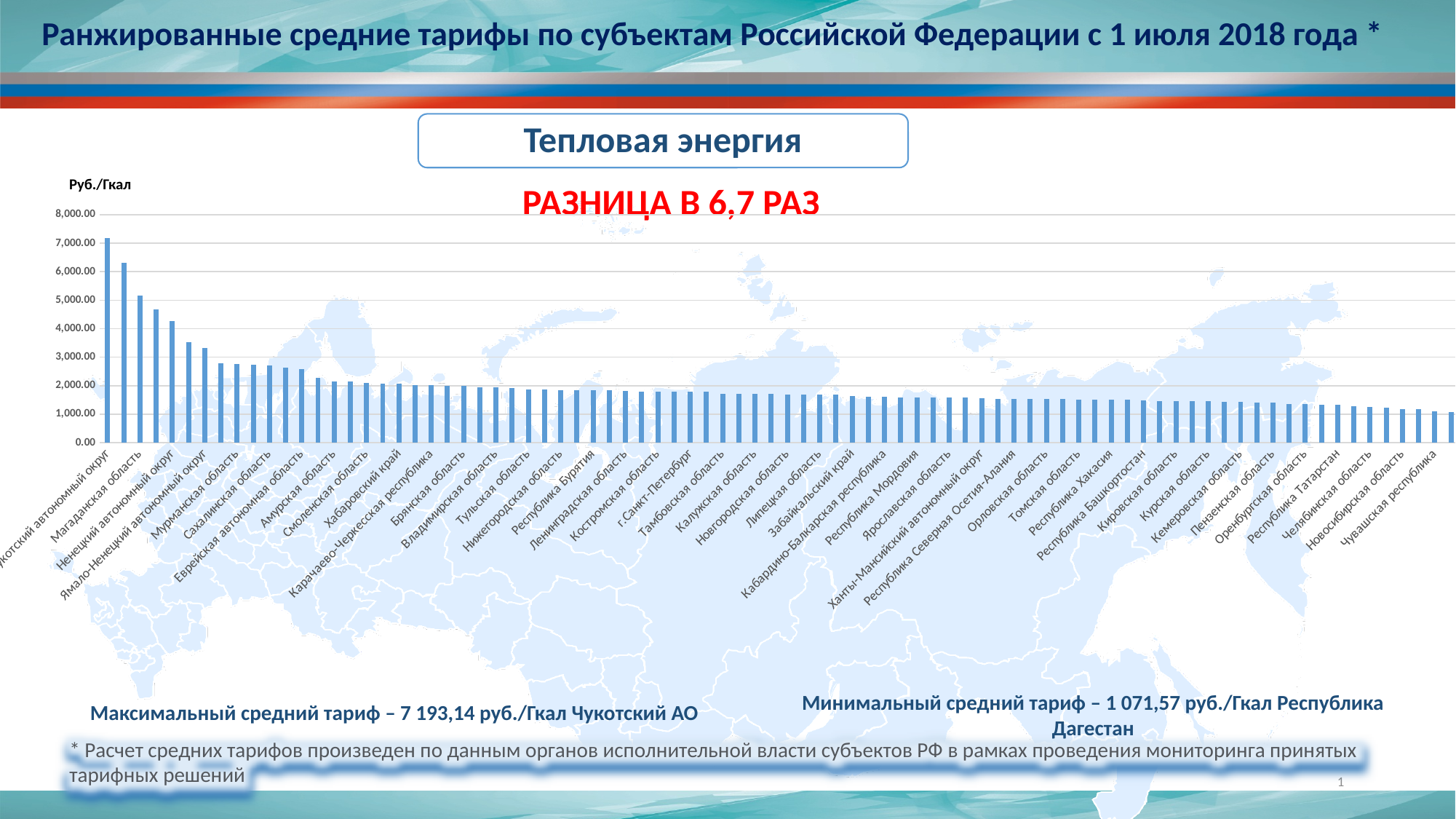
What kind of chart is shown on the slide? bar chart Is the value for Чувашская республика greater or less than 2,000.00? less What unit is shown on the vertical axis of the chart? Руб./Гкал By what factor does the slide say the tariffs differ? 6,7 раз Is the value for Магаданская область greater or less than 4,000.00? greater Is the value for Мурманская область greater or less than 5,000.00? less Which region has the highest average heat energy tariff in the chart? Чукотский автономный округ Which has the larger value, Магаданская область or Мурманская область? Магаданская область What is the maximum average tariff stated on the slide? 7 193,14 руб./Гкал Which region has the minimum average tariff according to the slide? Республика Дагестан Do the bar values rise or fall from left to right along the x axis? fall What is the minimum average tariff stated on the slide? 1 071,57 руб./Гкал